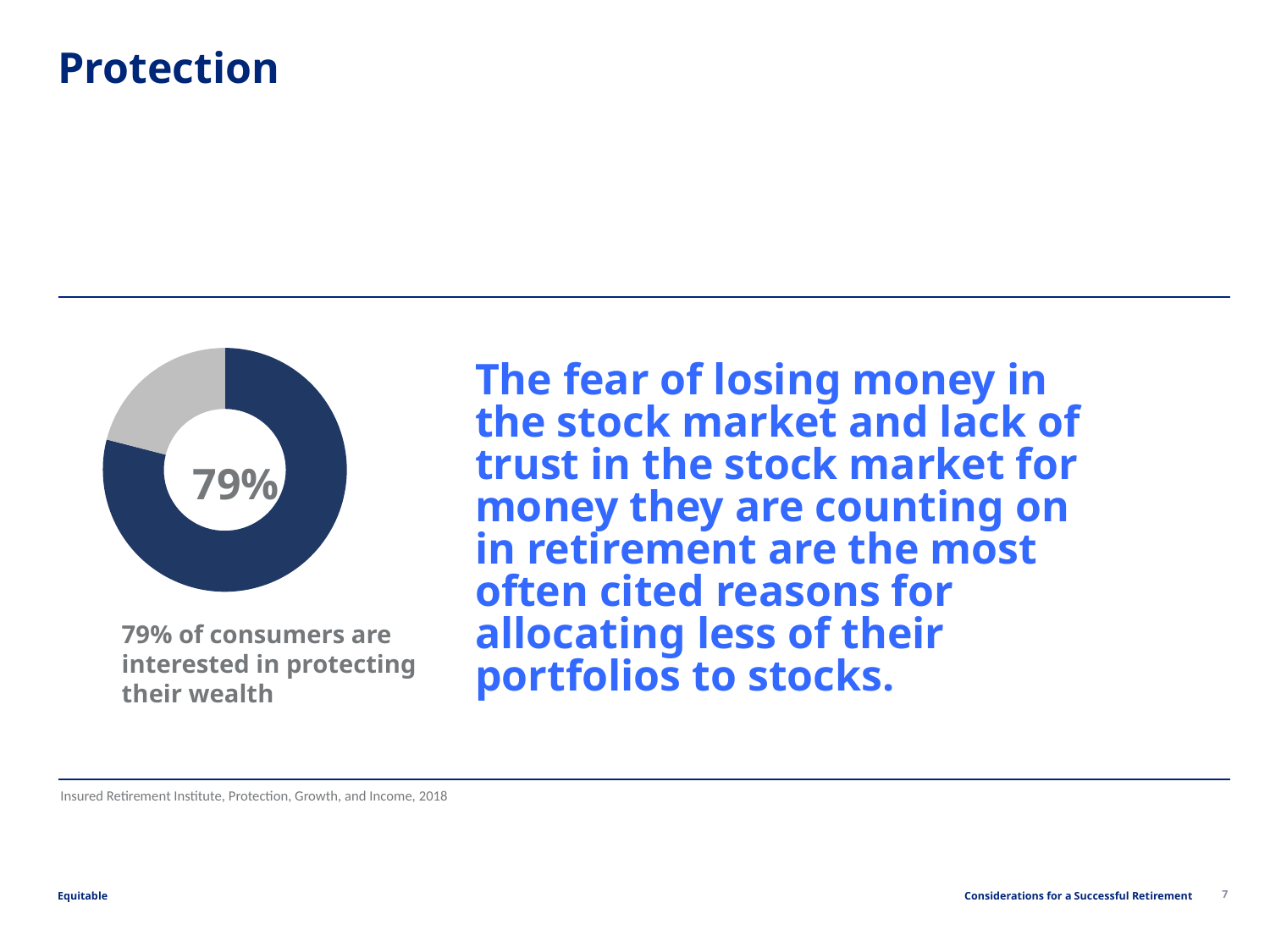
What percentage is printed in the centre of the donut chart? 79% What share of the donut chart does the grey slice represent? 21% What colour is the slice representing 79% in the donut chart? Dark blue What kind of chart is shown on the slide? Donut chart Is the grey slice of the donut chart greater or less than 25%? less Is the share of consumers interested in protecting their wealth greater or less than 50%? greater According to the chart, what share of consumers are interested in protecting their wealth? 79% How many slices does the donut chart have? 2 Which slice of the donut chart is larger, the dark blue one or the grey one? Dark blue What does the caption below the donut chart say the 79% represents? Consumers interested in protecting their wealth Which slice of the donut chart is the largest? The 79% dark blue slice